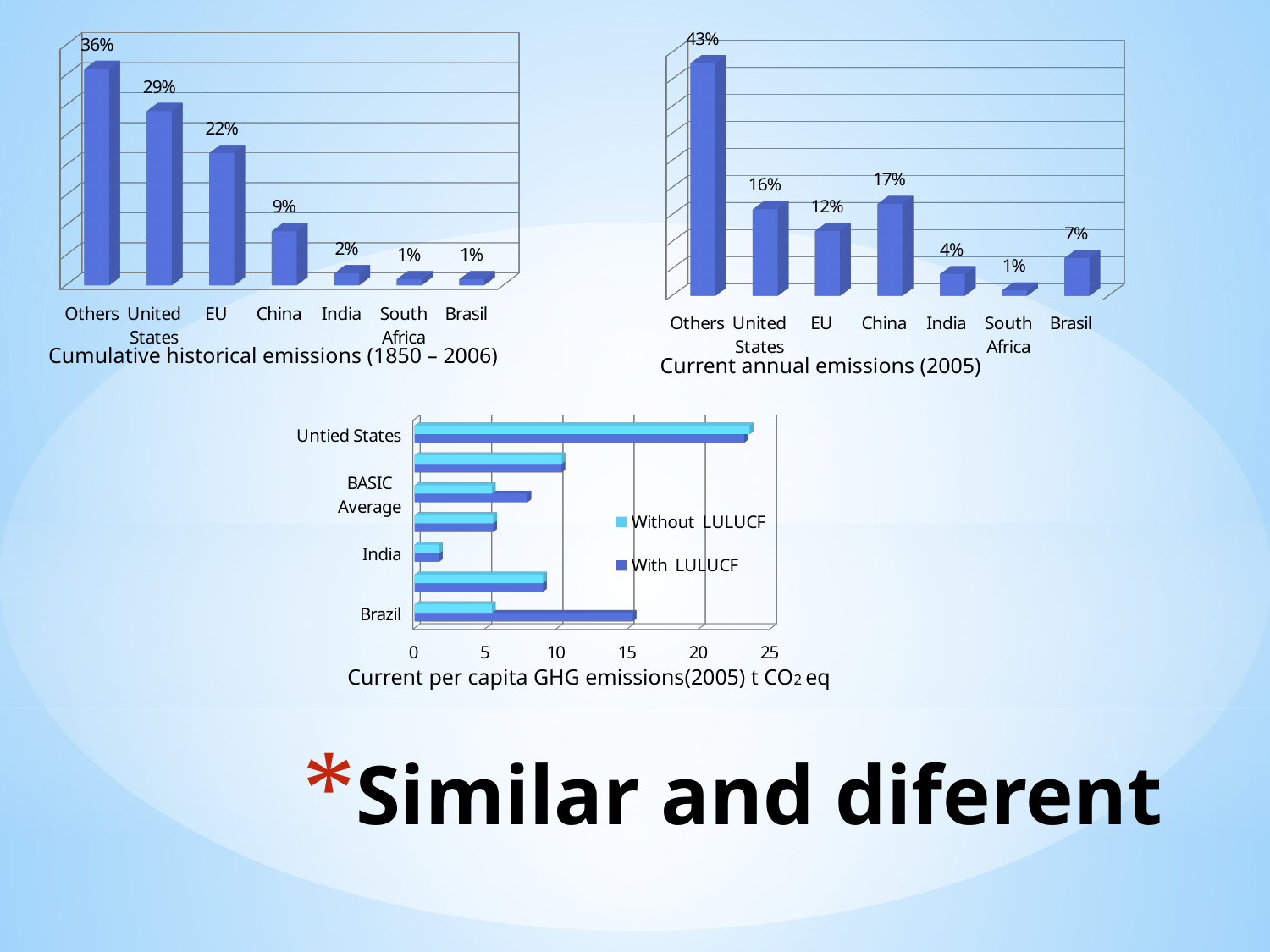
In the 'Current annual emissions (2005)' chart, what is the value for China? 17% In the 'Current annual emissions (2005)' chart, which is larger, the value for China or the value for the United States? China In the 'Current per capita GHG emissions(2005) t CO2 eq' chart, is the 'Without LULUCF' value for India greater or less than 5? less What kind of chart is the 'Current per capita GHG emissions(2005) t CO2 eq' chart? Bar chart In the 'Cumulative historical emissions (1850 – 2006)' chart, what is the difference between the EU and China values? 13% How many categories are shown in the 'Cumulative historical emissions (1850 – 2006)' chart? 7 In the 'Current per capita GHG emissions(2005) t CO2 eq' chart, is the 'Without LULUCF' value for Untied States greater or less than 20? greater In the 'Cumulative historical emissions (1850 – 2006)' chart, which category has the highest value? Others In the 'Cumulative historical emissions (1850 – 2006)' chart, what is the value for the United States? 29% In the 'Current annual emissions (2005)' chart, what is the difference between the Others value and the Brasil value? 36% How many series does the legend of the 'Current per capita GHG emissions(2005) t CO2 eq' chart list? 2 In the 'Current annual emissions (2005)' chart, which category has the lowest value? South Africa